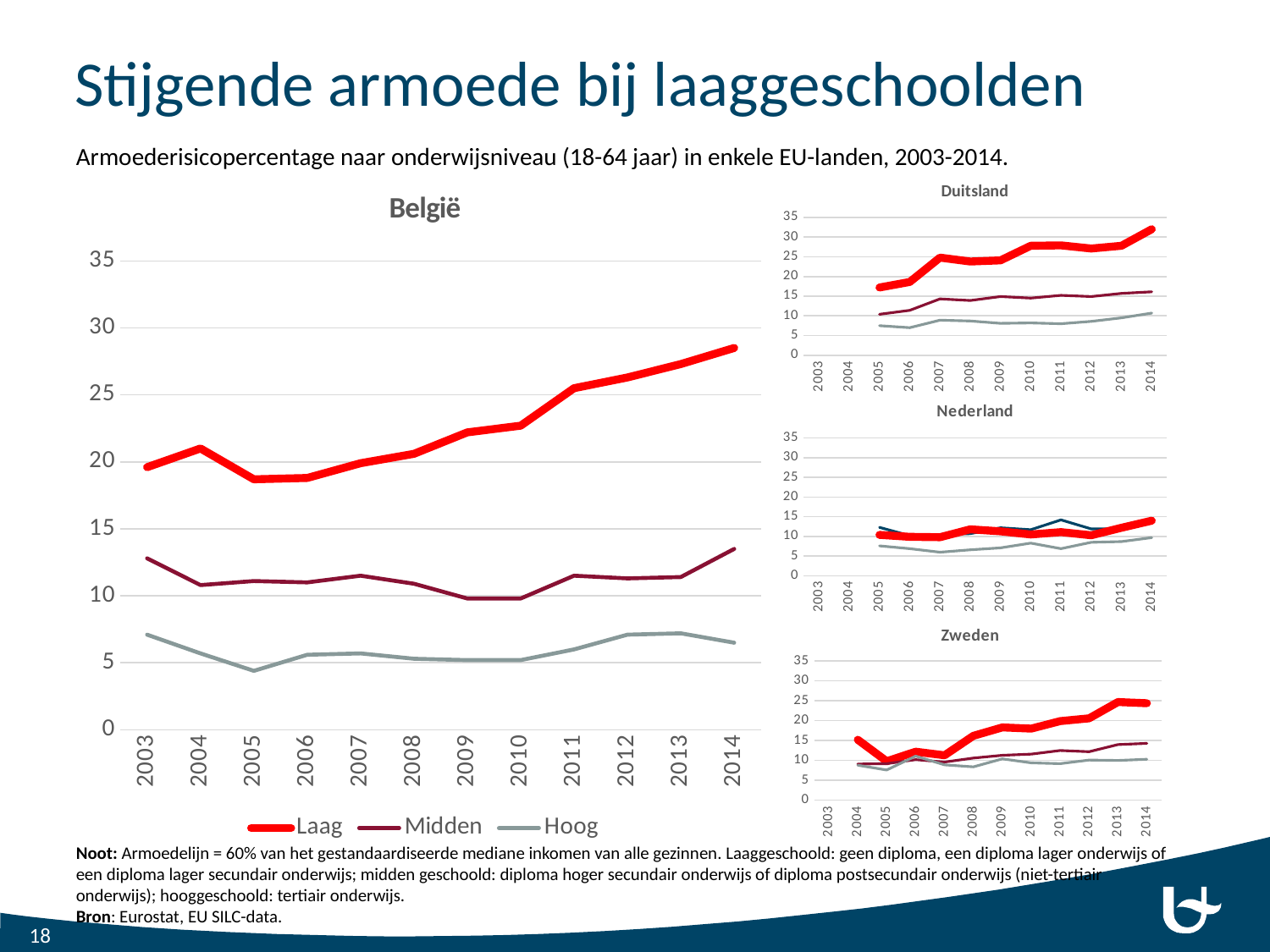
In the België chart, which series has the highest value in 2014? Laag In the Zweden chart, is the value for Laag in 2014 greater or less than 20? greater In the België chart, which series has the lowest value in 2014? Hoog In the België chart, is the value for Laag in 2014 greater or less than 25? greater In the Duitsland chart, is the value for Laag in 2014 greater or less than 30? greater What are the three legend entries of the België chart? Laag, Midden, Hoog What kind of chart is the België chart? line chart How many years are shown on the x axis of the België chart? 12 In the België chart, does the Laag series rise or fall between 2005 and 2014? rise How many series does the legend of the België chart list? 3 In the België chart, is the Laag value larger in 2003 or in 2014? 2014